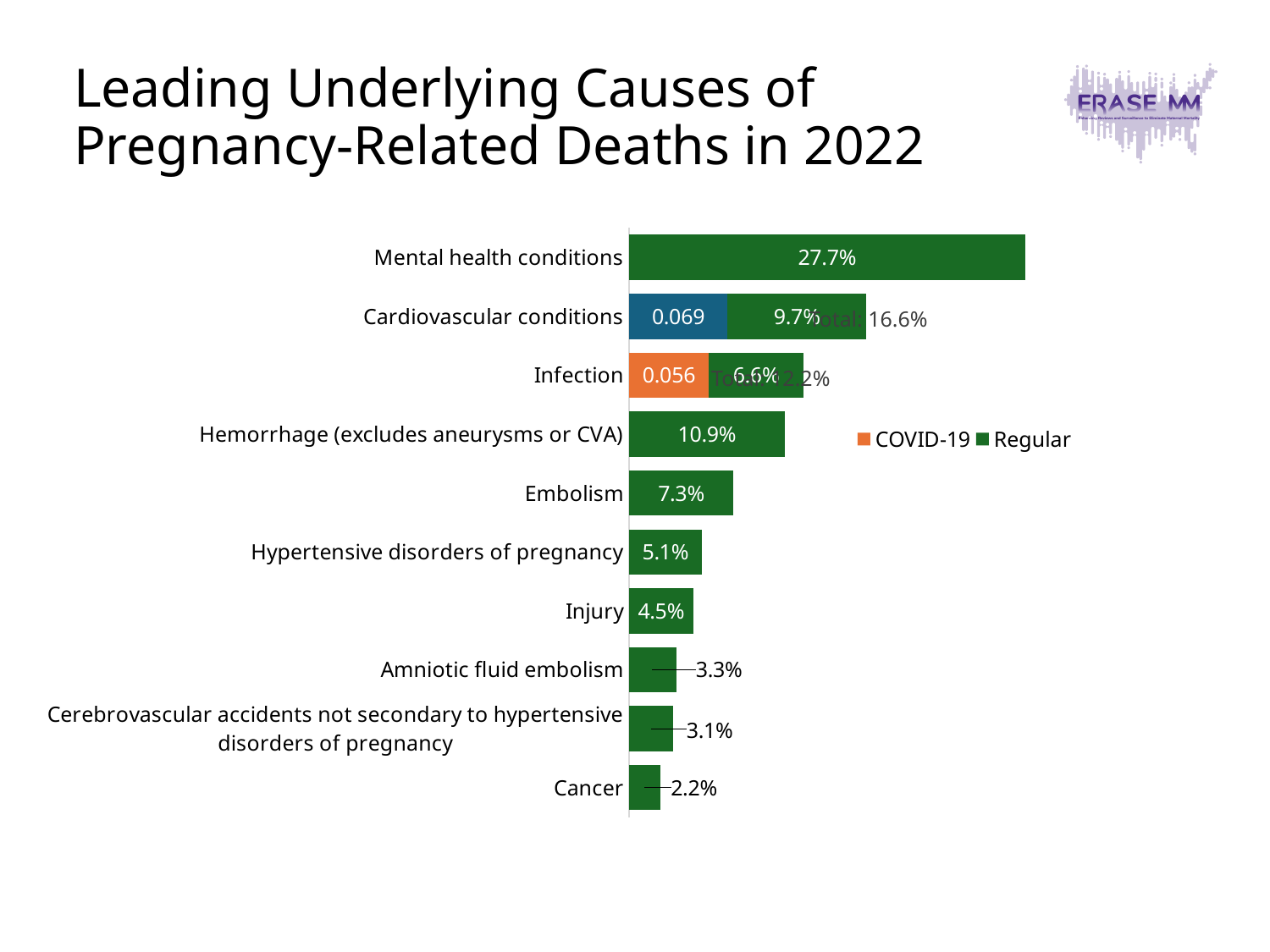
How many series does the legend list? 2 How many causes of death are listed on the chart? 10 What is the value for Hemorrhage (excludes aneurysms or CVA)? 10.9% What is the value for Mental health conditions? 27.7% What is the difference between the values for Embolism and Hypertensive disorders of pregnancy? 2.2 percentage points What is the value for Cancer? 2.2% What kind of chart is shown on the slide? Bar chart Which is larger, the value for Injury or the value for Amniotic fluid embolism? Injury Which cause has the highest value? Mental health conditions What are the two series named in the legend? COVID-19 and Regular What is the Regular value for Cardiovascular conditions? 9.7% Which cause has the lowest value? Cancer